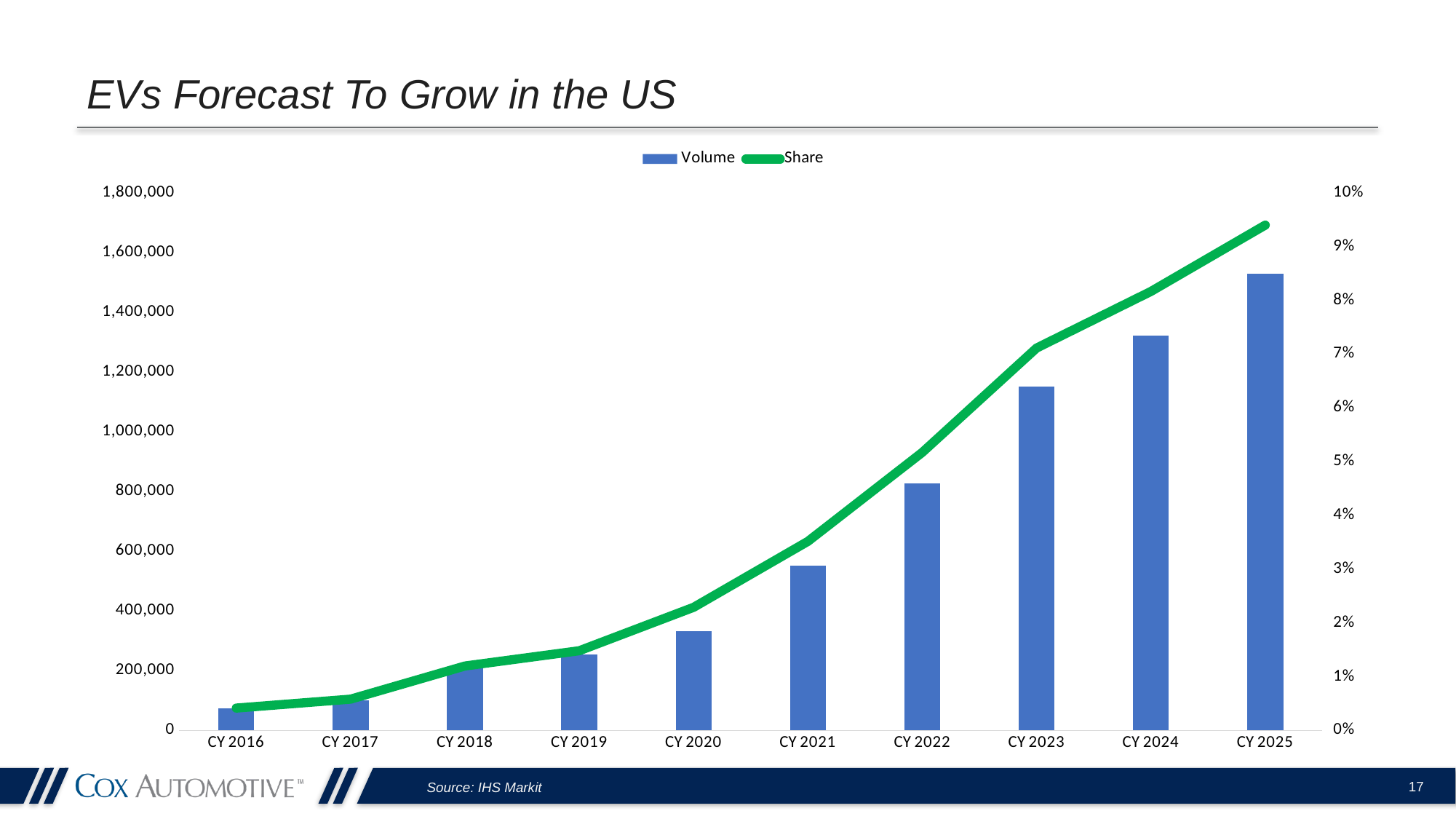
Which is larger, the Volume for CY 2024 or the Volume for CY 2022? CY 2024 Is the Volume for CY 2023 greater or less than 1,000,000? greater How many series does the legend list? 2 Which year has the lowest Volume bar? CY 2016 Is the Share for CY 2016 greater or less than 1%? less What kind of chart is shown on the slide? A combination bar and line chart Is the Share for CY 2025 greater or less than 9%? greater How many calendar years are shown on the x axis? 10 Do the Share values rise or fall from CY 2016 to CY 2025? Rise Which year has the highest Volume bar? CY 2025